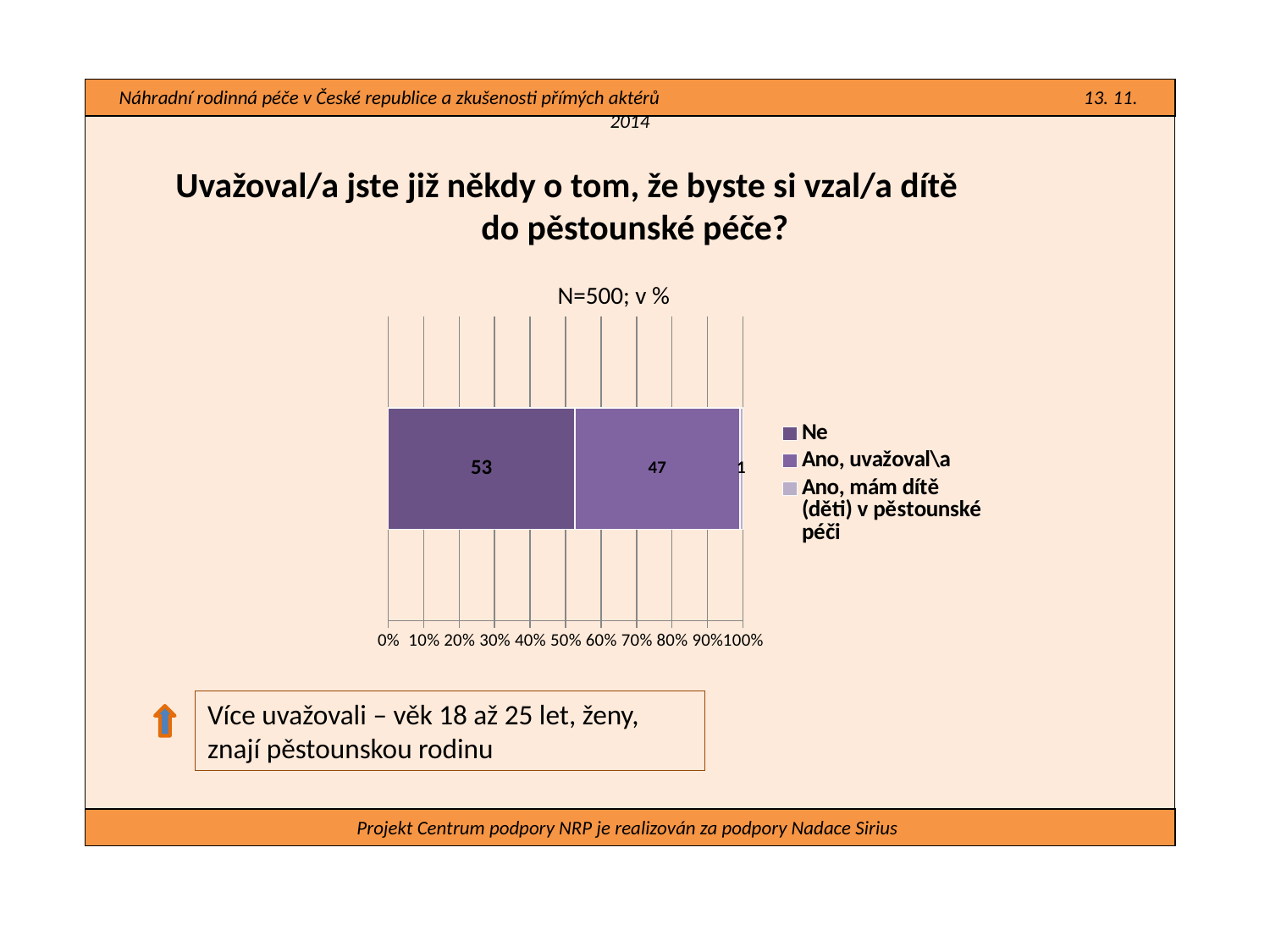
What is the total of the stacked bar? 101 What is the title of the chart? N=500; v % Which series has the smallest value in the bar? Ano, mám dítě (děti) v pěstounské péči What value is shown for the "Ano, uvažoval\a" segment of the bar? 47 Which is larger, the "Ne" value or the "Ano, uvažoval\a" value? Ne Is the value for "Ne" greater or less than 50%? greater What value is shown for the "Ne" segment of the bar? 53 What value is shown for the "Ano, mám dítě (děti) v pěstounské péči" segment of the bar? 1 Which series has the largest value in the bar? Ne What is the difference between the "Ne" value and the "Ano, uvažoval\a" value? 6 What kind of chart is shown on the slide? Stacked bar chart How many series does the legend list? 3